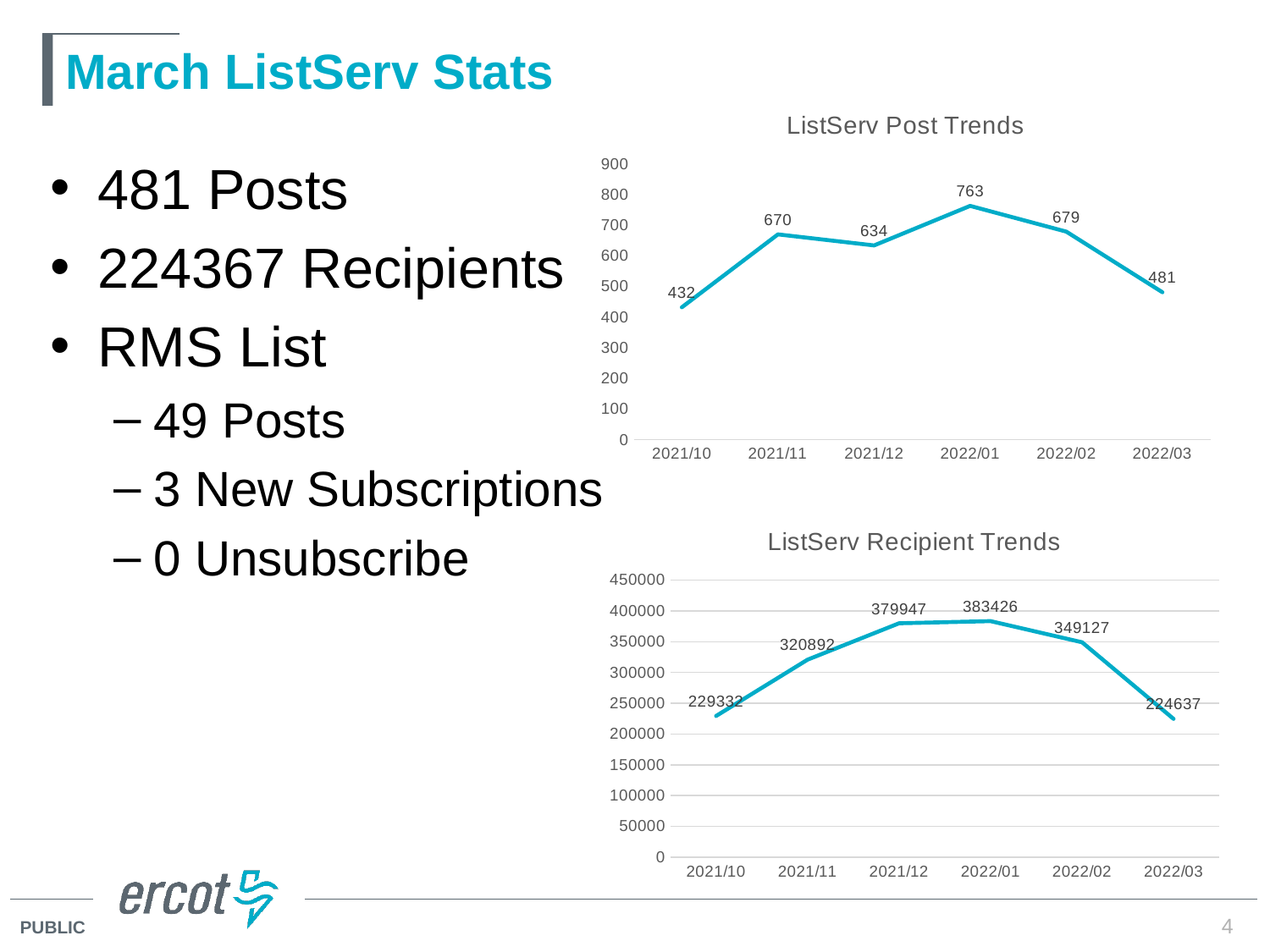
In the ListServ Recipient Trends chart, is the value for 2021/10 greater or less than 250000? less In the ListServ Recipient Trends chart, what is the difference between the values for 2022/01 and 2022/03? 158789 In the ListServ Post Trends chart, is the value for 2021/11 greater or less than 2021/12? greater In the ListServ Post Trends chart, what is the difference between the values for 2022/02 and 2022/03? 198 In the ListServ Post Trends chart, which month has the lowest value? 2021/10 What is the title of the lower chart on the slide? ListServ Recipient Trends In the ListServ Recipient Trends chart, do the values rise or fall from 2022/01 to 2022/03? fall In the ListServ Post Trends chart, what is the value for 2022/01? 763 What type of chart is the ListServ Post Trends chart? Line chart In the ListServ Recipient Trends chart, what is the value for 2021/11? 320892 In the ListServ Post Trends chart, how many data points are plotted? 6 In the ListServ Recipient Trends chart, which month has the highest value? 2022/01